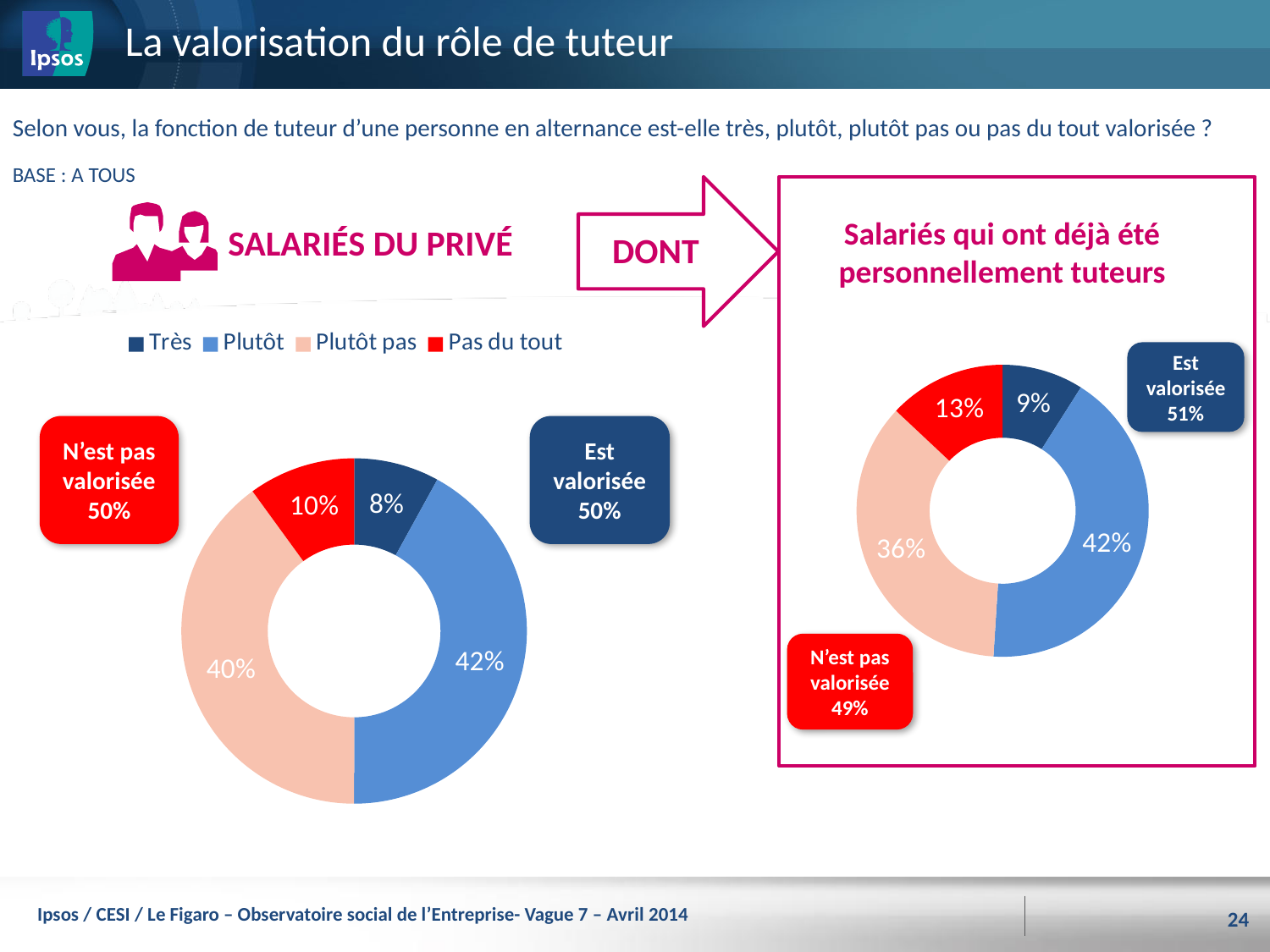
In the 'Salariés du privé' chart, what is the combined share of 'Très' and 'Plutôt'? 50% In the 'Salariés du privé' chart, which response has the smallest share? Très How many series does the legend list? 4 In the 'Salariés qui ont déjà été personnellement tuteurs' chart, what percentage answered 'Plutôt pas'? 36% In the 'Salariés qui ont déjà été personnellement tuteurs' chart, which is larger: 'Pas du tout' or 'Très'? Pas du tout In the 'Salariés qui ont déjà été personnellement tuteurs' chart, which response has the largest share? Plutôt In the 'Salariés du privé' chart, what percentage answered 'Pas du tout'? 10% In the 'Salariés du privé' chart, what is the difference between the 'Plutôt pas' and 'Pas du tout' shares? 30 percentage points What kind of chart is used on the slide? Donut (pie) chart What colour represents 'Plutôt pas' in the charts? Light pink/peach In the 'Salariés du privé' chart, what percentage answered 'Plutôt'? 42% In the 'Salariés qui ont déjà été personnellement tuteurs' chart, what percentage answered 'Très'? 9%